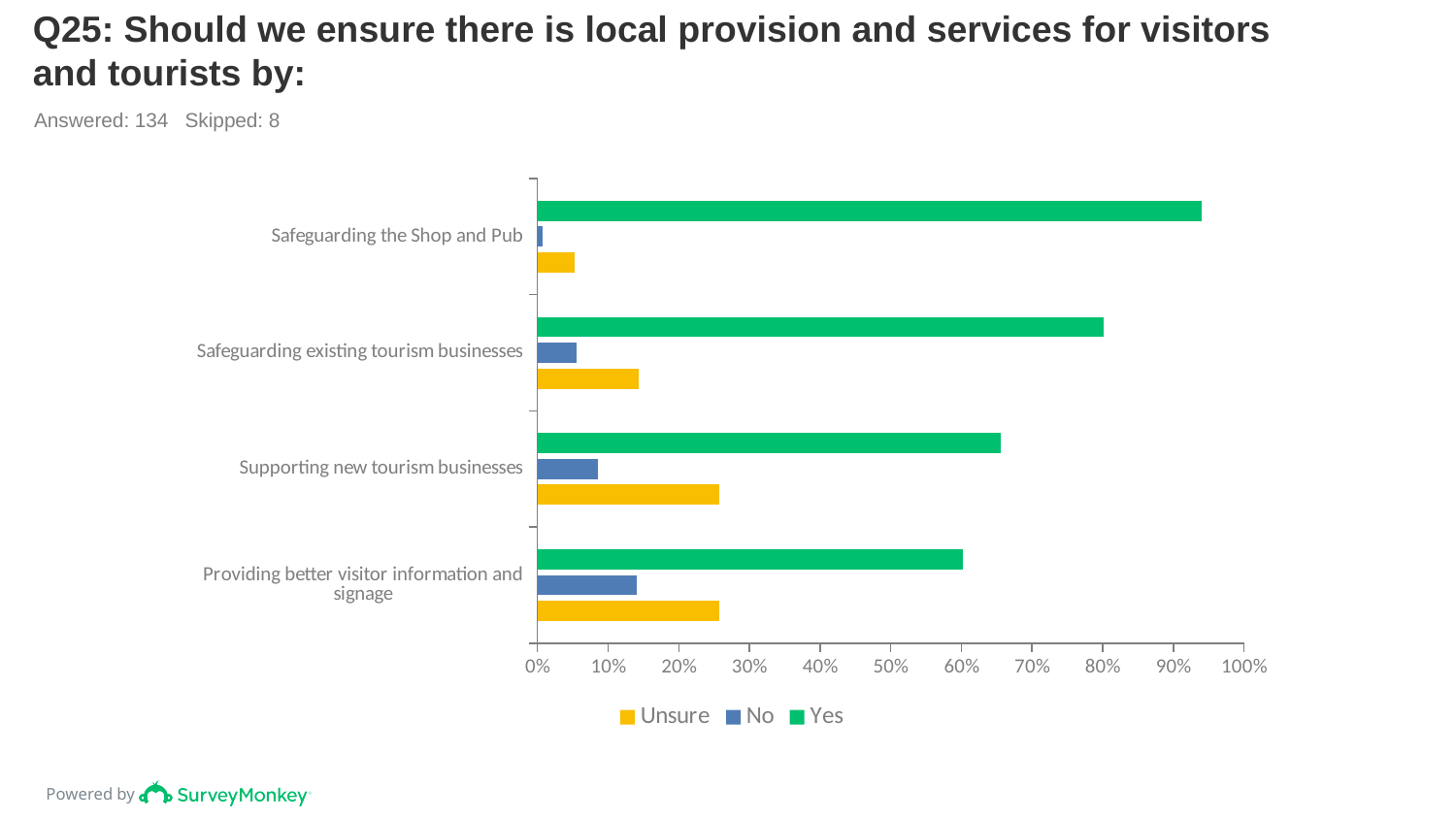
What are the three entries listed in the chart legend? Unsure, No, Yes Is the 'Yes' value for Safeguarding the Shop and Pub greater or less than 90%? greater Which category has the highest 'No' value? Providing better visitor information and signage Is the 'Yes' value for Supporting new tourism businesses greater or less than 70%? less Which category has the lowest 'Yes' value? Providing better visitor information and signage Is the 'Unsure' value for Supporting new tourism businesses greater or less than 20%? greater Which is larger: the 'Unsure' value for Safeguarding existing tourism businesses or the 'Unsure' value for Safeguarding the Shop and Pub? Safeguarding existing tourism businesses How many categories (options) are plotted on the chart? 4 Which category has the highest 'Yes' value? Safeguarding the Shop and Pub How many series does the legend list? 3 What kind of chart is shown on the slide? Bar chart